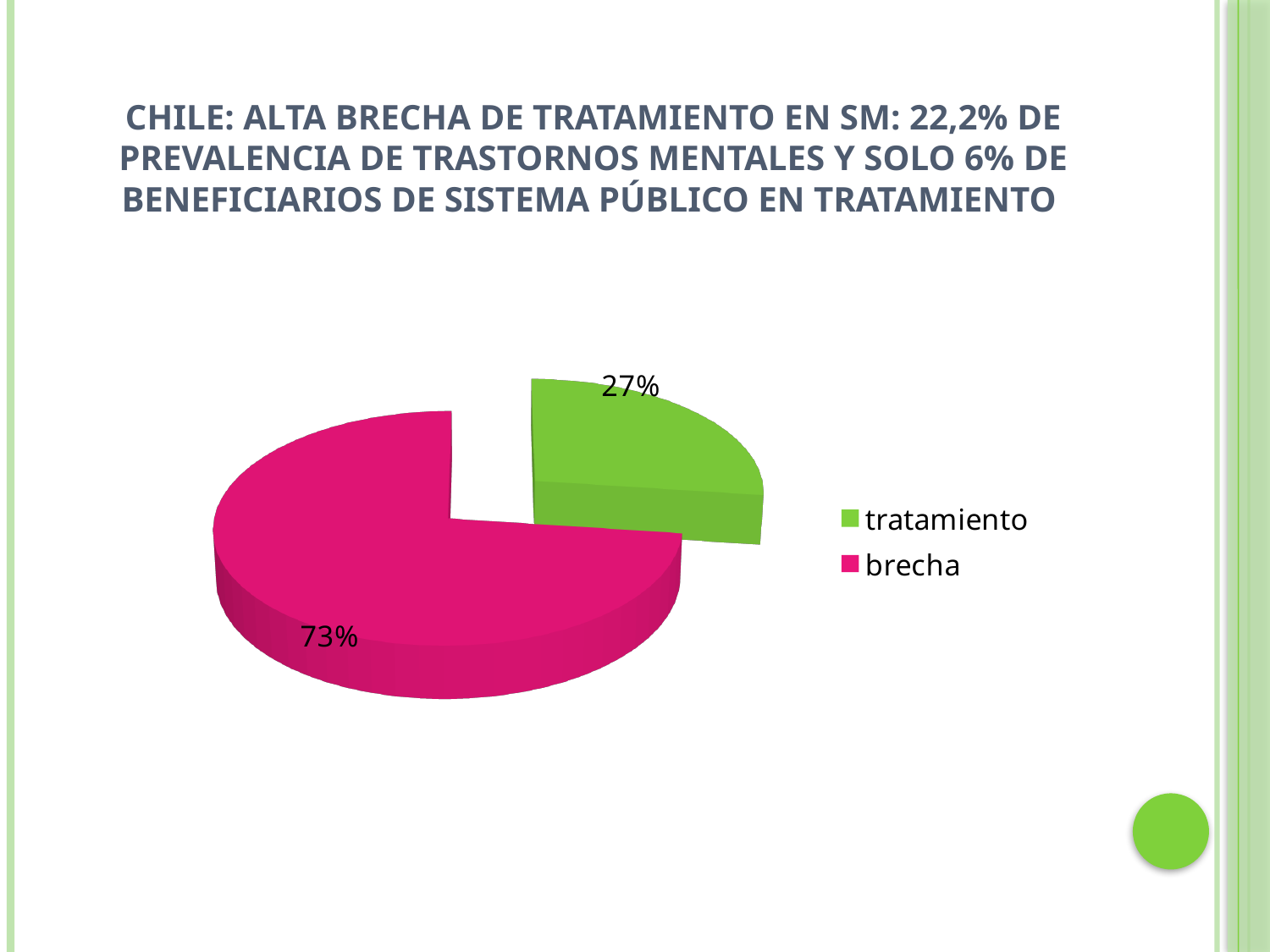
Which slice of the pie is the largest? brecha What share of the pie does the 'brecha' slice represent? 73% Which is larger, the 'tratamiento' slice or the 'brecha' slice? brecha What colour is the 'tratamiento' slice? green What share of the pie does the 'tratamiento' slice represent? 27% How many slices does the pie chart have? 2 Which slice of the pie is the smallest? tratamiento What is the difference in percentage points between the 'brecha' and 'tratamiento' slices? 46 What kind of chart is shown on the slide? pie chart How many entries does the legend list? 2 What colour is the 'brecha' slice? pink